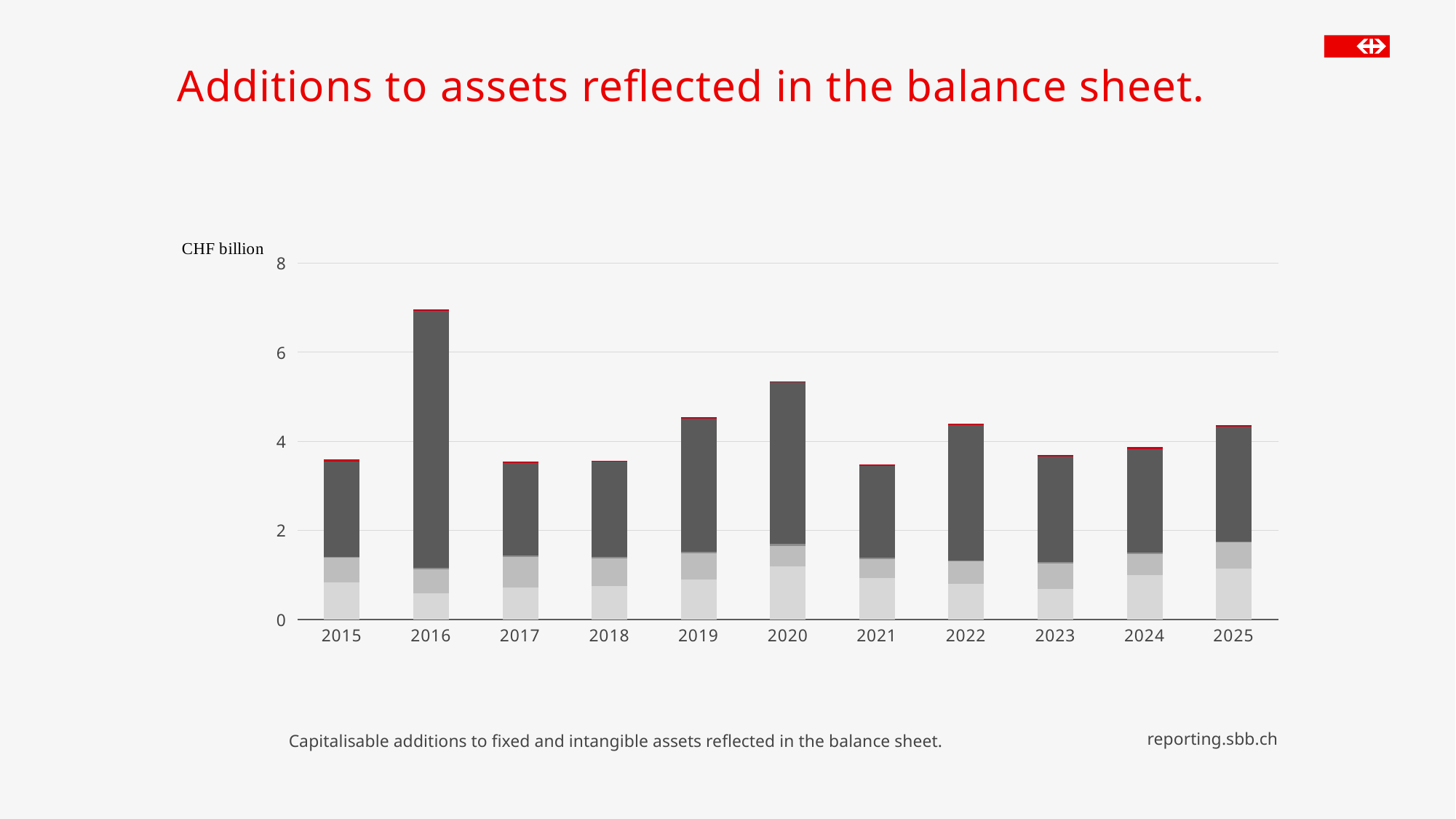
Which year has the larger total, 2019 or 2021? 2019 Which year has the larger total, 2016 or 2020? 2016 Is the total value for 2016 greater or less than 6? greater Which year has the highest total additions to assets? 2016 How many years are shown on the x axis of the chart? 11 Is the total value for 2021 greater or less than 4? less Is the total value for 2023 greater or less than 4? less Do the total values rise or fall from 2016 to 2018? fall What kind of chart is shown on the slide? Stacked bar chart What unit is shown on the y axis of the chart? CHF billion